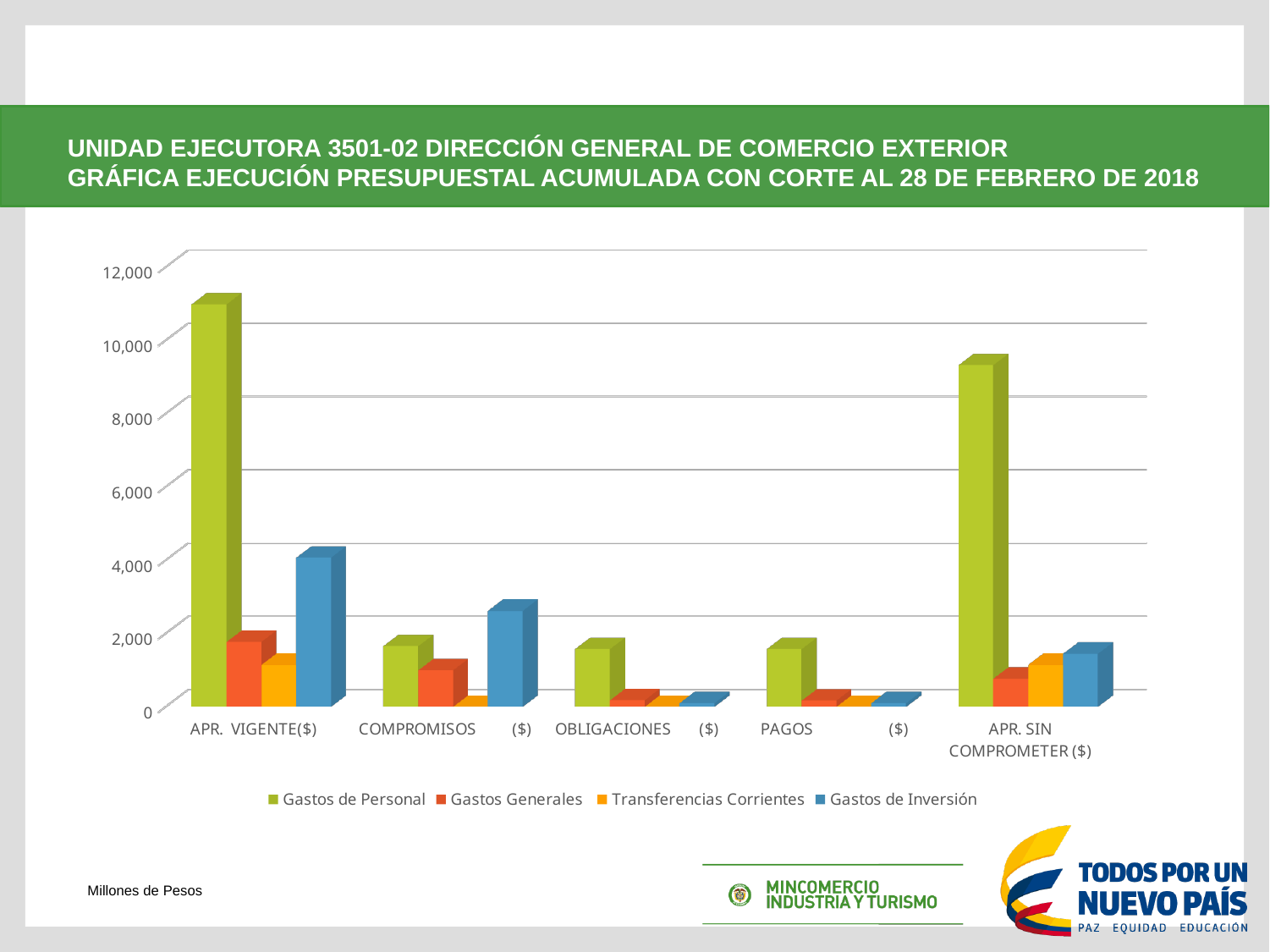
Which category has the highest value for Gastos de Personal? APR. VIGENTE($) What unit is stated for the values in the chart? Millones de Pesos How many series does the legend list? 4 Which series has the highest value in the COMPROMISOS ($) category? Gastos de Inversión Which is larger in APR. VIGENTE($): Gastos de Inversión or Gastos Generales? Gastos de Inversión What kind of chart is shown on the slide? bar chart Which is larger in APR. SIN COMPROMETER ($): Gastos de Personal or Gastos de Inversión? Gastos de Personal Is the value for Gastos de Personal in APR. SIN COMPROMETER ($) greater or less than 10,000? less Is the value for Gastos de Inversión in COMPROMISOS ($) greater or less than 2,000? greater Is the value for Gastos de Personal in APR. VIGENTE($) greater or less than 10,000? greater How many categories are shown along the x axis? 5